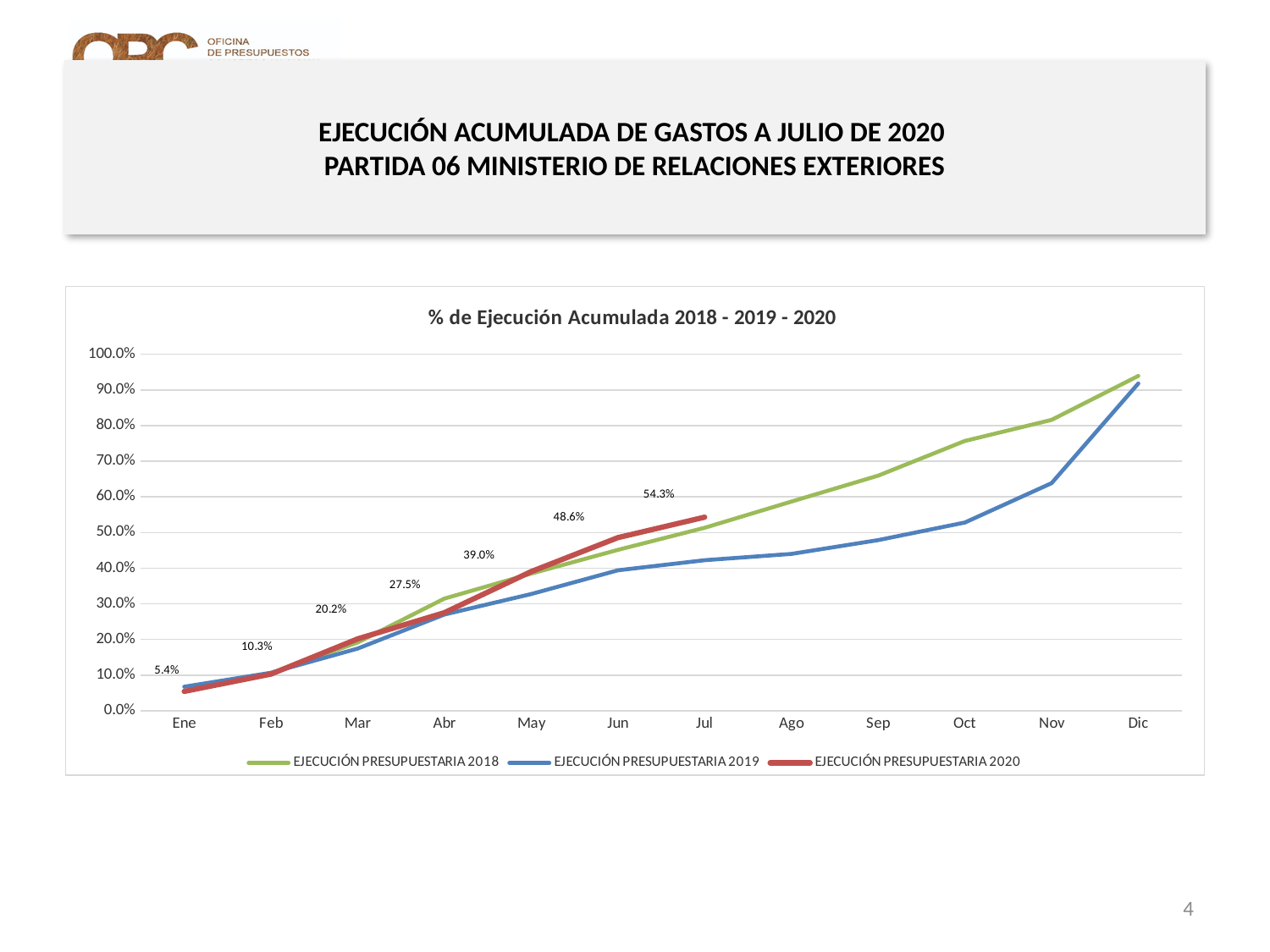
What is the value of EJECUCIÓN PRESUPUESTARIA 2020 in Jul? 54.3% Is the value for EJECUCIÓN PRESUPUESTARIA 2018 in Nov greater or less than 70.0%? greater Which month has the highest value for EJECUCIÓN PRESUPUESTARIA 2020? Jul What is the difference between the EJECUCIÓN PRESUPUESTARIA 2020 values for Mar and Feb? 9.9% What is the value of EJECUCIÓN PRESUPUESTARIA 2020 in Abr? 27.5% What is the value of EJECUCIÓN PRESUPUESTARIA 2020 in May? 39.0% What is the value of EJECUCIÓN PRESUPUESTARIA 2020 in Ene? 5.4% Is the value for EJECUCIÓN PRESUPUESTARIA 2019 in Oct greater or less than 60.0%? less Does the EJECUCIÓN PRESUPUESTARIA 2020 line rise or fall from Ene to Jul? Rise What kind of chart is shown on the slide? Line chart What is the difference between the EJECUCIÓN PRESUPUESTARIA 2020 values for Jul and Jun? 5.7% How many series does the legend list? 3